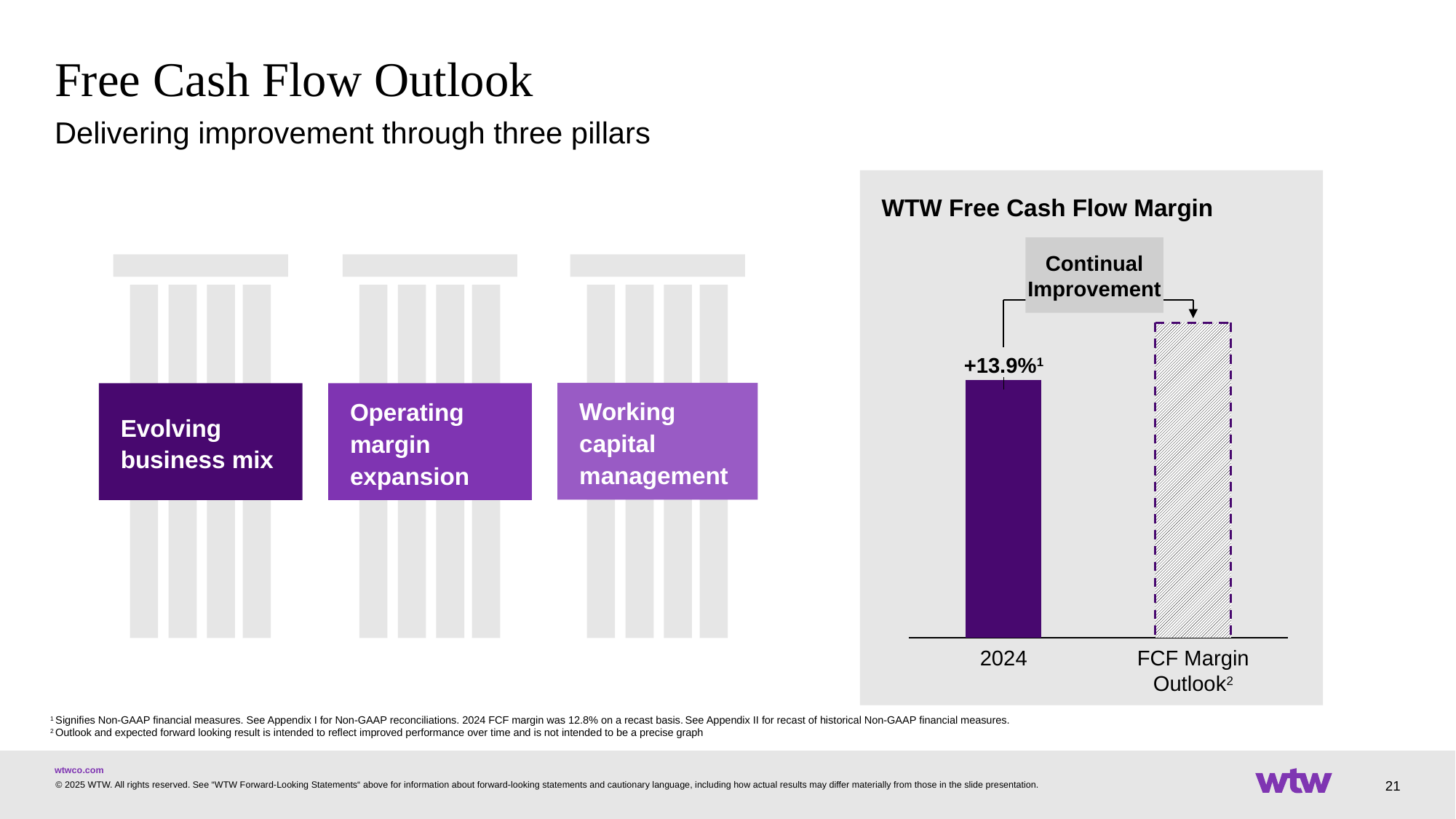
Which bar is taller in the WTW Free Cash Flow Margin chart, 2024 or FCF Margin Outlook? FCF Margin Outlook Do the bars rise or fall from 2024 to FCF Margin Outlook in the WTW Free Cash Flow Margin chart? Rise What kind of chart is the WTW Free Cash Flow Margin chart? Bar chart What is the value shown for 2024 in the WTW Free Cash Flow Margin chart? +13.9% Which category has the lowest bar in the WTW Free Cash Flow Margin chart? 2024 What is the title of the chart on the slide? WTW Free Cash Flow Margin Which category has the highest bar in the WTW Free Cash Flow Margin chart? FCF Margin Outlook What label is shown in the box above the arrow pointing to the FCF Margin Outlook bar? Continual Improvement What are the two category labels on the x axis of the WTW Free Cash Flow Margin chart? 2024 and FCF Margin Outlook How many bars are plotted in the WTW Free Cash Flow Margin chart? 2